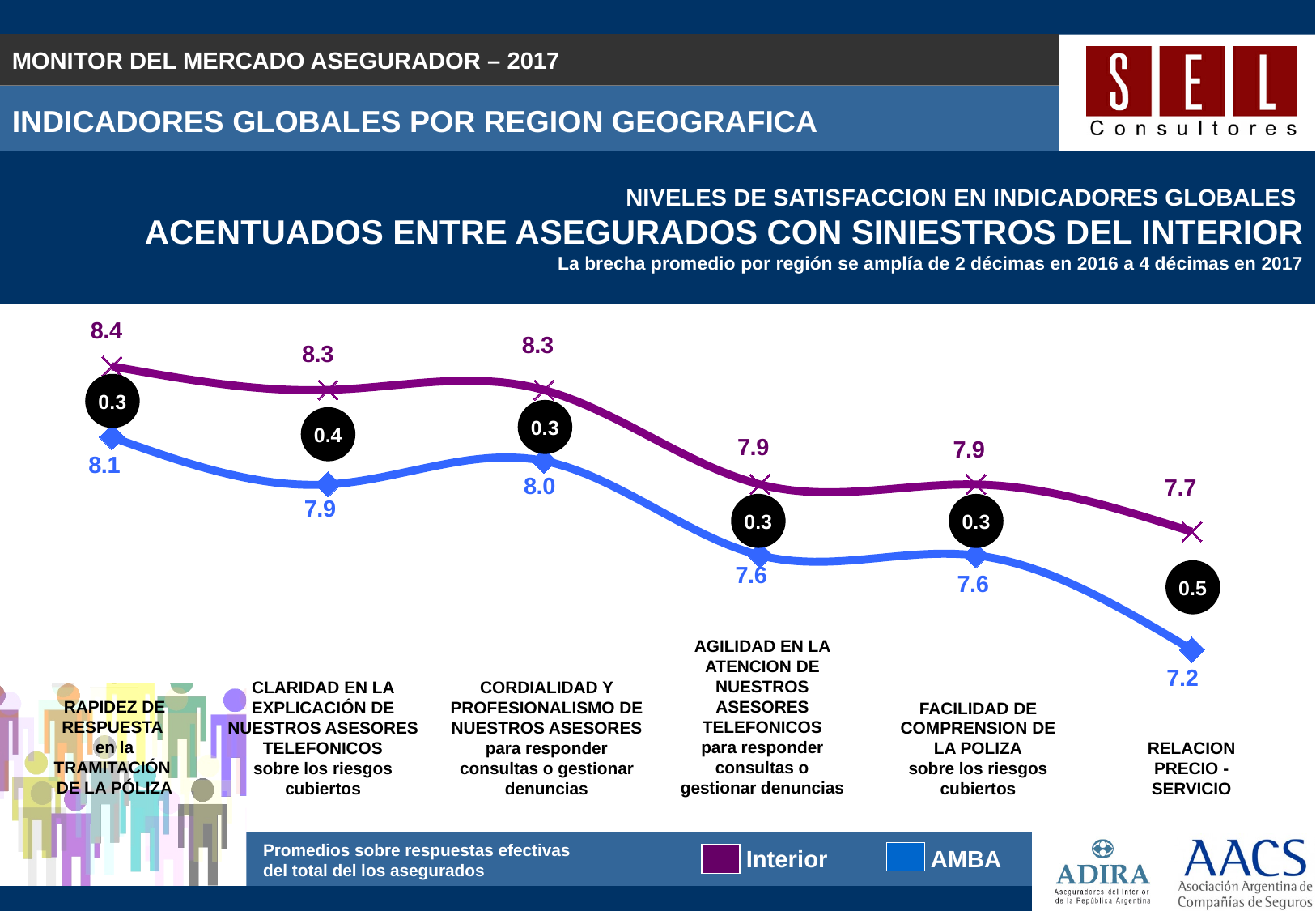
What type of chart is shown on the slide? Line chart Which category has the lowest AMBA value? RELACION PRECIO - SERVICIO What is the Interior value for FACILIDAD DE COMPRENSION DE LA POLIZA? 7.9 How many series does the legend list? 2 How many categories are plotted on the chart? 6 What is the AMBA value for RELACION PRECIO - SERVICIO? 7.2 Which category has the highest Interior value? RAPIDEZ DE RESPUESTA en la TRAMITACIÓN DE LA PÓLIZA What is the difference between the Interior and AMBA values for CLARIDAD EN LA EXPLICACIÓN DE NUESTROS ASESORES TELEFONICOS? 0.4 For AGILIDAD EN LA ATENCION DE NUESTROS ASESORES TELEFONICOS, which series has the higher value, Interior or AMBA? Interior What is the Interior value for RAPIDEZ DE RESPUESTA en la TRAMITACIÓN DE LA PÓLIZA? 8.4 What is the AMBA value for CORDIALIDAD Y PROFESIONALISMO DE NUESTROS ASESORES? 8.0 What is the difference between the Interior and AMBA values for RELACION PRECIO - SERVICIO? 0.5